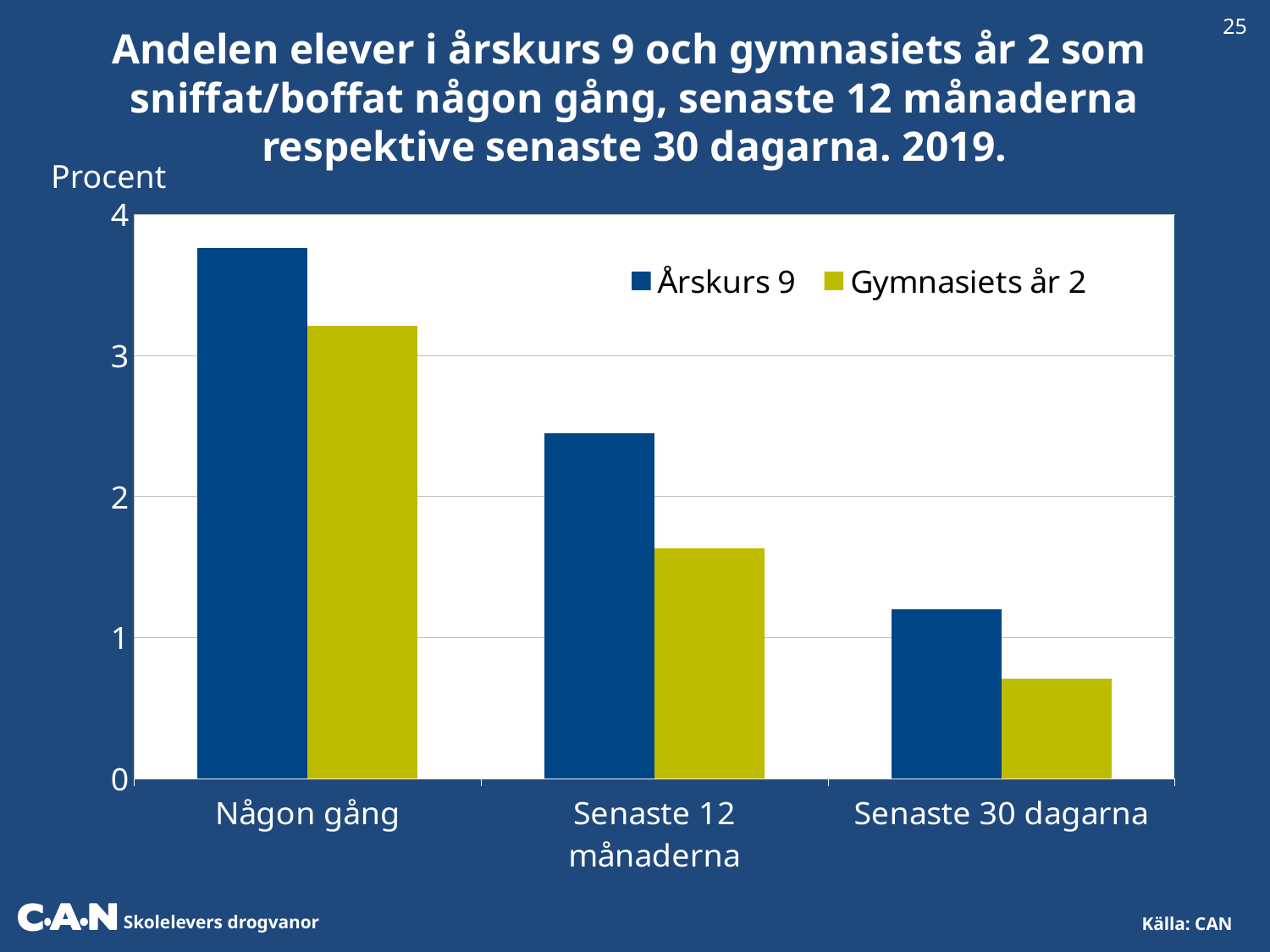
Which category has the lowest value for Gymnasiets år 2? Senaste 30 dagarna Is the value for Årskurs 9 in Någon gång greater or less than 3? greater How many series does the legend list? 2 How many categories are shown on the x axis? 3 What unit is shown on the y axis label? Procent Is the value for Årskurs 9 in Senaste 12 månaderna greater or less than 2? greater Do the values for Årskurs 9 rise or fall from left to right across the categories? fall Which category has the highest value for Årskurs 9? Någon gång For Senaste 12 månaderna, which series has the larger value, Årskurs 9 or Gymnasiets år 2? Årskurs 9 What kind of chart is shown on the slide? bar chart Is the value for Gymnasiets år 2 in Senaste 30 dagarna greater or less than 1? less What colour are the bars for Gymnasiets år 2? yellow-green